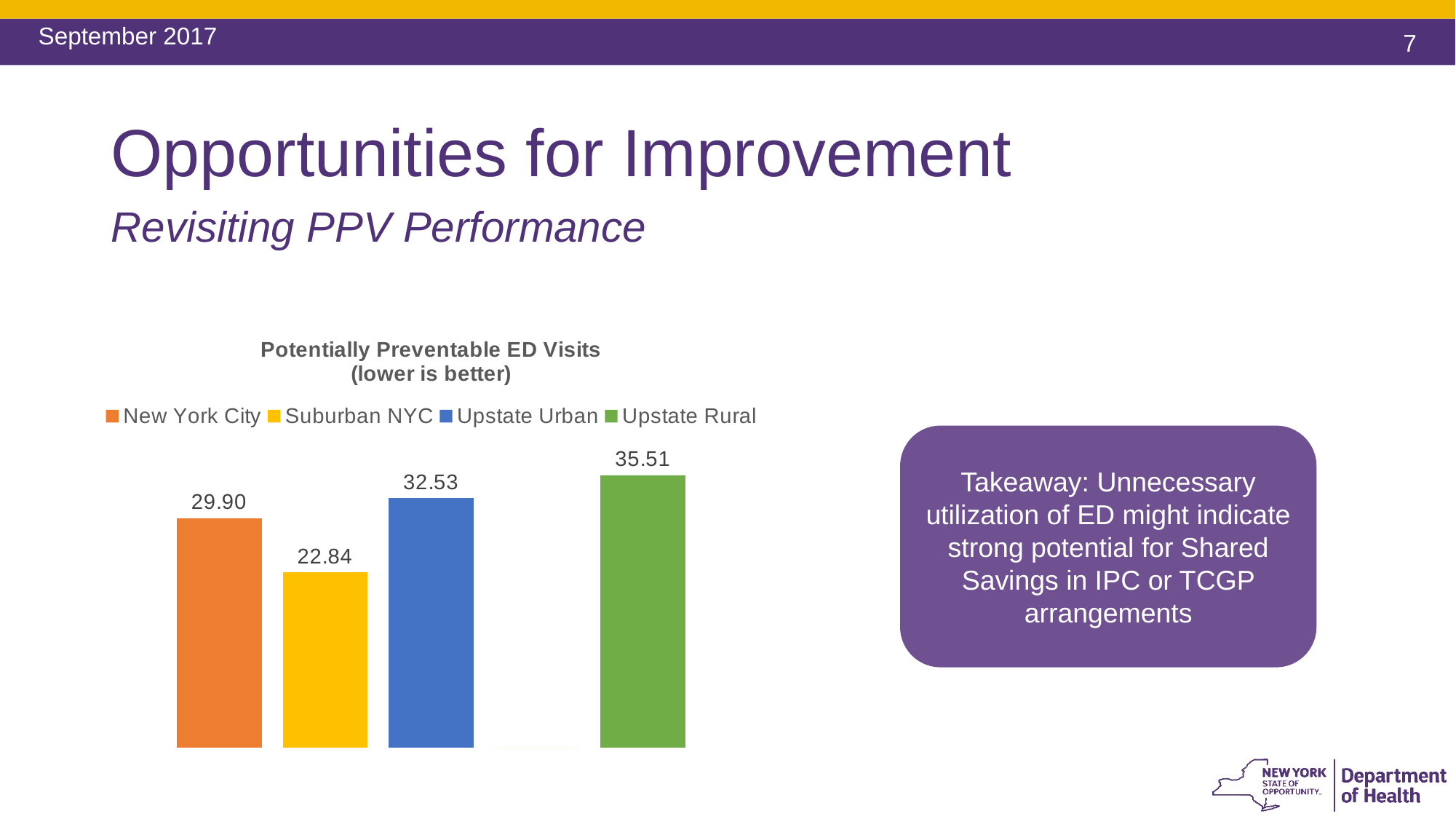
Which region has the highest value in the Potentially Preventable ED Visits chart? Upstate Rural What is the difference between the Upstate Urban and New York City values in the Potentially Preventable ED Visits chart? 2.63 What is the value for New York City in the Potentially Preventable ED Visits chart? 29.90 What is the value for Suburban NYC in the Potentially Preventable ED Visits chart? 22.84 What is the value for Upstate Rural in the Potentially Preventable ED Visits chart? 35.51 What kind of chart is shown on the slide? Bar chart Which is larger in the Potentially Preventable ED Visits chart, New York City or Upstate Urban? Upstate Urban What is the difference between the Upstate Rural and Suburban NYC values in the Potentially Preventable ED Visits chart? 12.67 Which region has the lowest value in the Potentially Preventable ED Visits chart? Suburban NYC How many series does the legend of the Potentially Preventable ED Visits chart list? 4 What is the value for Upstate Urban in the Potentially Preventable ED Visits chart? 32.53 What colour is the Upstate Rural bar in the Potentially Preventable ED Visits chart? Green